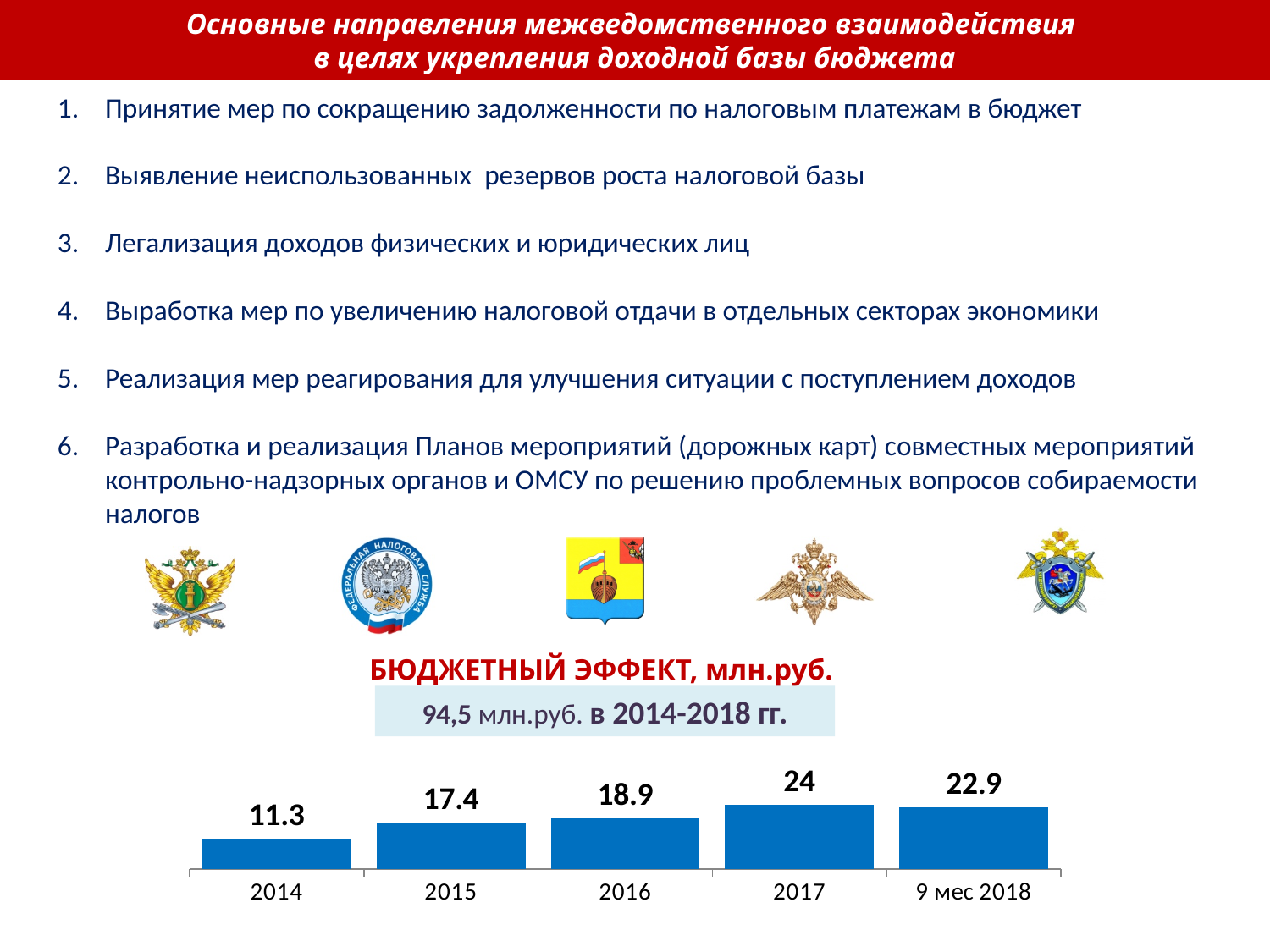
Which category has the highest value in the chart? 2017 What is the value for 9 мес 2018 in the chart? 22.9 What is the value for 2014 in the chart? 11.3 How many categories are shown on the x axis of the chart? 5 Which category has the lowest value in the chart? 2014 What is the title of the chart? БЮДЖЕТНЫЙ ЭФФЕКТ, млн.руб. What is the difference between the values for 2017 and 2014? 12.7 Which is larger, the value for 2017 or the value for 9 мес 2018? 2017 What kind of chart is shown on the slide? bar chart What is the difference between the values for 2016 and 2015? 1.5 Do the values rise or fall from 2014 to 2017? rise What is the value for 2016 in the chart? 18.9